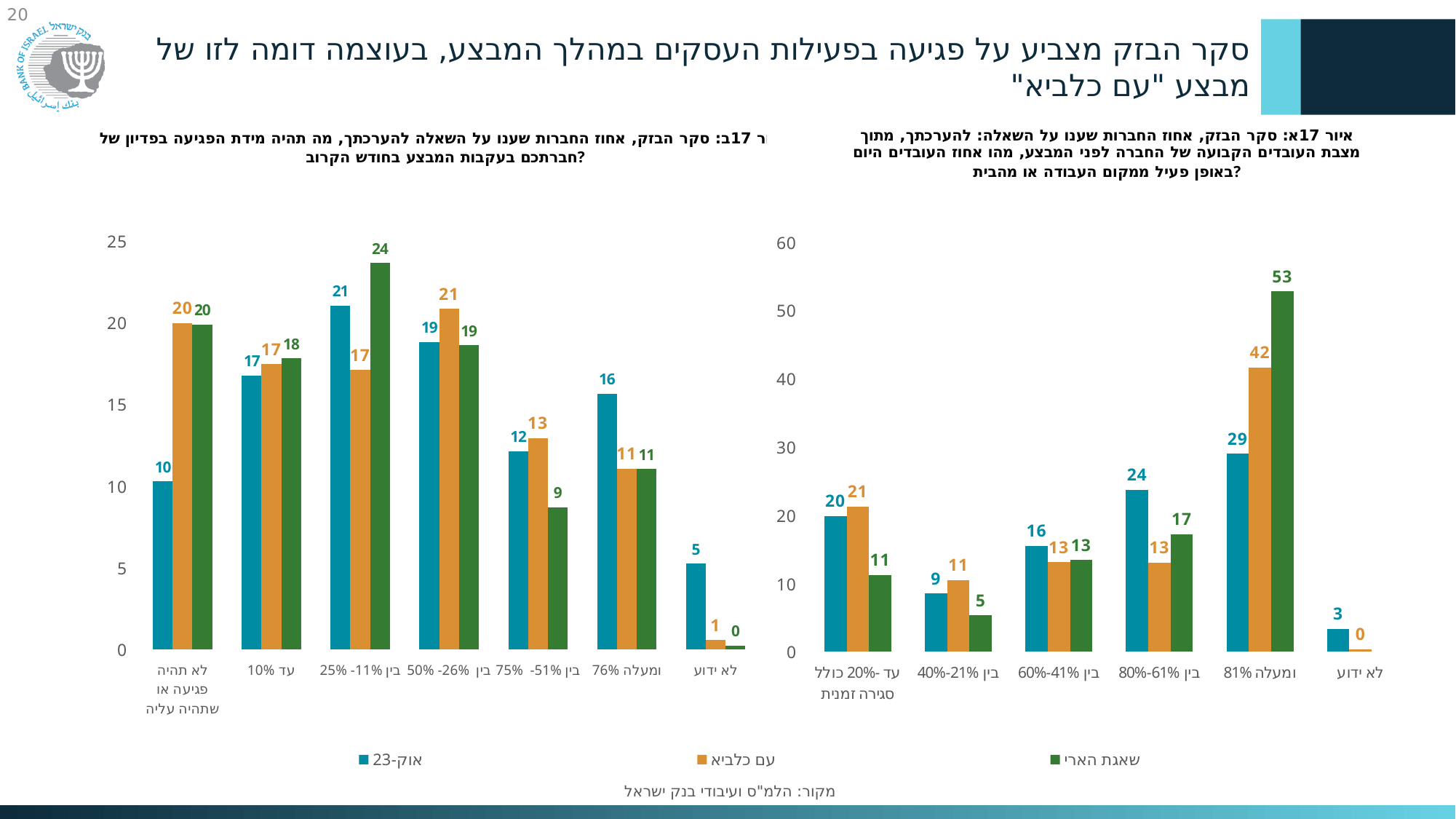
What type of chart is used on this slide? Bar chart In the right-hand chart (איור 17א), which category has the highest value for עם כלביא? 81% ומעלה In the right-hand chart (איור 17א), what is the difference between the שאגת הארי and אוק-23 values in the category 81% ומעלה? 24 In the left-hand chart (איור 17ב), what is the difference between the עם כלביא and אוק-23 values in the category לא תהיה פגיעה או שתהיה עליה? 10 How many series does the legend list? 3 In the left-hand chart (איור 17ב), what is the value for שאגת הארי in the category בין 11%-25%? 24 In the left-hand chart (איור 17ב), which category has the lowest value for אוק-23? לא ידוע In the left-hand chart (איור 17ב), what is the value for אוק-23 in the category לא ידוע? 5 In the right-hand chart (איור 17א), which is larger in the category בין 21%-40%: the value for עם כלביא or for שאגת הארי? עם כלביא In the right-hand chart (איור 17א), what is the value for שאגת הארי in the category 81% ומעלה? 53 How many categories are shown on the x axis of the left-hand chart (איור 17ב)? 7 In the right-hand chart (איור 17א), what is the value for אוק-23 in the category בין 61%-80%? 24